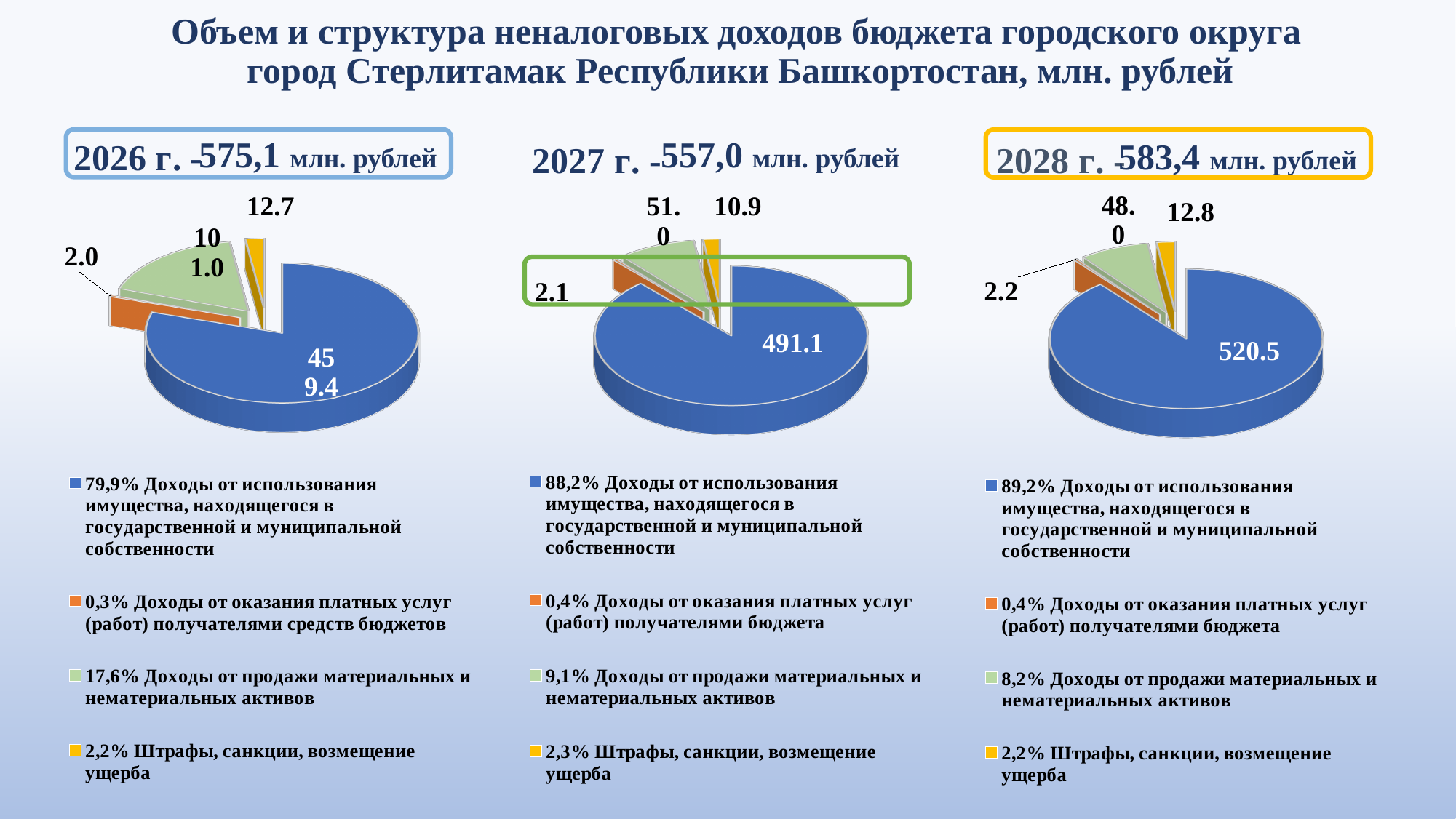
In the 2027 pie chart, what is the value for income from paid services (Доходы от оказания платных услуг)? 2.1 According to the legend of the 2028 pie chart, what share of non-tax revenue comes from use of state and municipal property? 89,2% According to the legend of the 2026 pie chart, what share of non-tax revenue comes from sale of tangible and intangible assets (Доходы от продажи материальных и нематериальных активов)? 17,6% In the 2028 pie chart, which category has the smallest slice? Доходы от оказания платных услуг (работ) получателями бюджета In the 2028 pie chart, what is the value for fines, sanctions and damage compensation (Штрафы, санкции, возмещение ущерба)? 12.8 In the 2027 pie chart, which category has the largest slice? Доходы от использования имущества, находящегося в государственной и муниципальной собственности In the 2026 pie chart, what is the value for fines, sanctions and damage compensation (Штрафы, санкции, возмещение ущерба)? 12.7 In the 2027 pie chart, what is the value for income from use of state and municipal property (Доходы от использования имущества)? 491.1 What is the difference between the 2028 and 2027 values for income from use of state and municipal property (520.5 vs 491.1)? 29.4 What type of chart is used for each of the three years on the slide? Pie chart In the 2028 pie chart, what is the value for income from use of state and municipal property (Доходы от использования имущества)? 520.5 How many slices does each pie chart on the slide have? 4